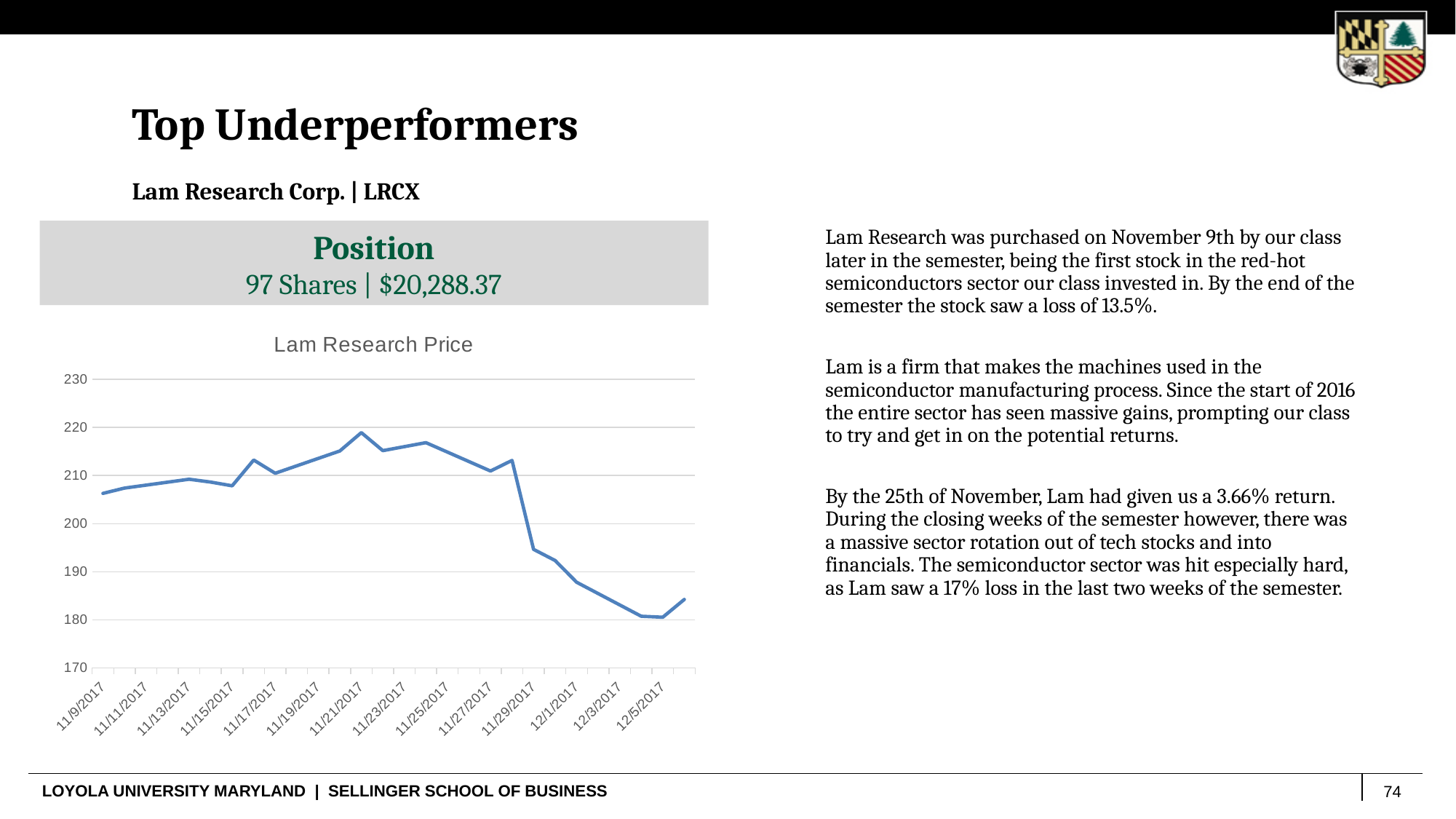
How many date labels are shown on the x axis of the chart? 14 Is the Lam Research price on 11/17/2017 greater or less than 200? greater What is the highest value shown on the y axis of the chart? 230 Which date has the higher Lam Research price, 11/21/2017 or 12/5/2017? 11/21/2017 Is the Lam Research price on 11/21/2017 greater or less than 210? greater On which date does the Lam Research price reach its highest point? 11/21/2017 What kind of chart is shown on the slide? line chart Is the Lam Research price on 11/9/2017 greater or less than 200? greater What is the title of the chart? Lam Research Price Overall, does the Lam Research price rise or fall from 11/9/2017 to the end of the chart? fall